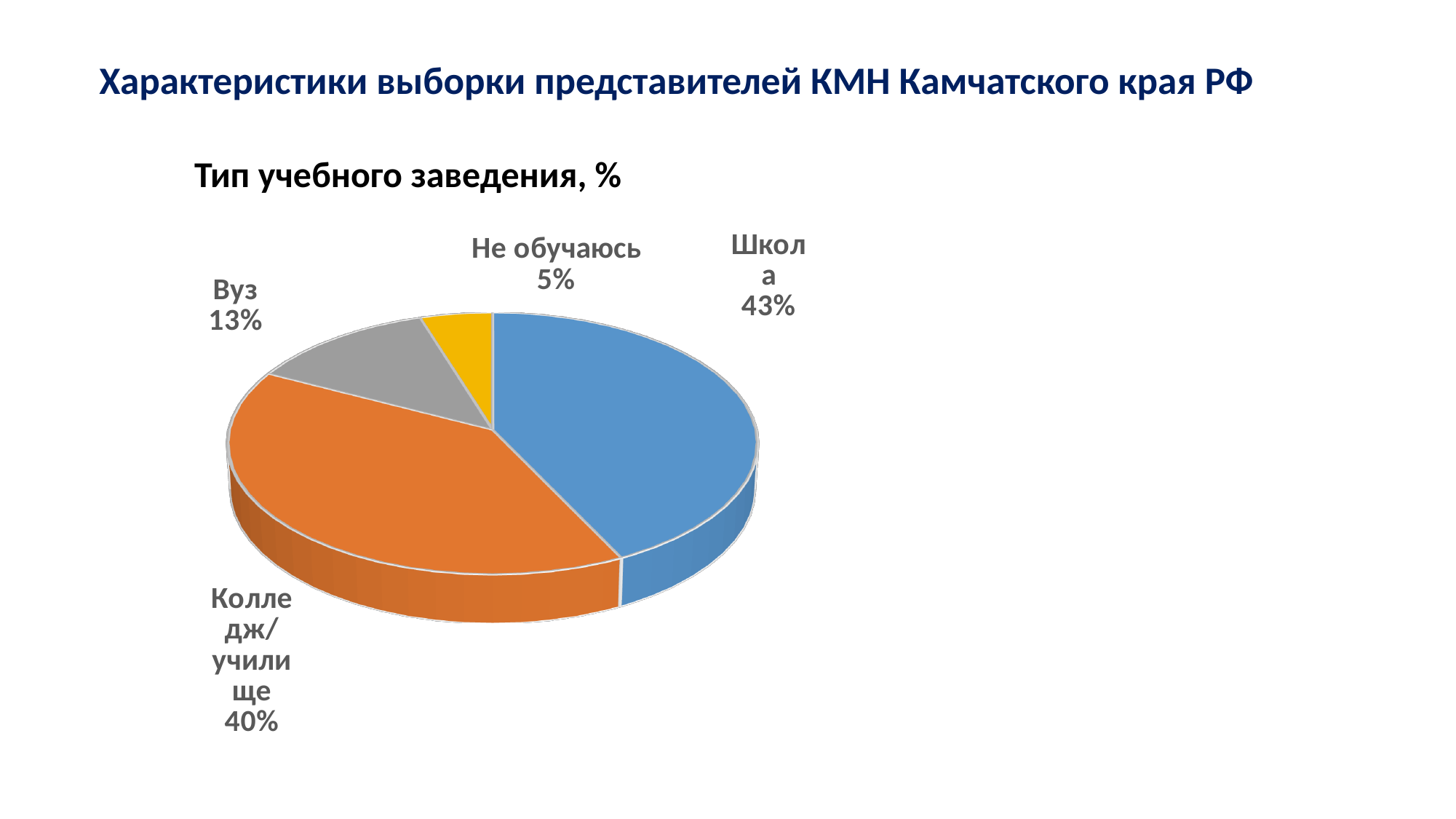
What is the difference in percentage points between Вуз and Не обучаюсь? 8 What share of the pie does Не обучаюсь have? 5% What share of the pie does Колледж/училище have? 40% What is the title of the chart? Тип учебного заведения, % What kind of chart is shown on the slide? Pie chart Which is larger, the share for Вуз or the share for Не обучаюсь? Вуз What share of the pie does Вуз have? 13% What is the difference in percentage points between Школа and Колледж/училище? 3 How many categories are shown in the pie chart? 4 Which category has the largest share of the pie? Школа What share of the pie does Школа have? 43% Which category has the smallest share of the pie? Не обучаюсь